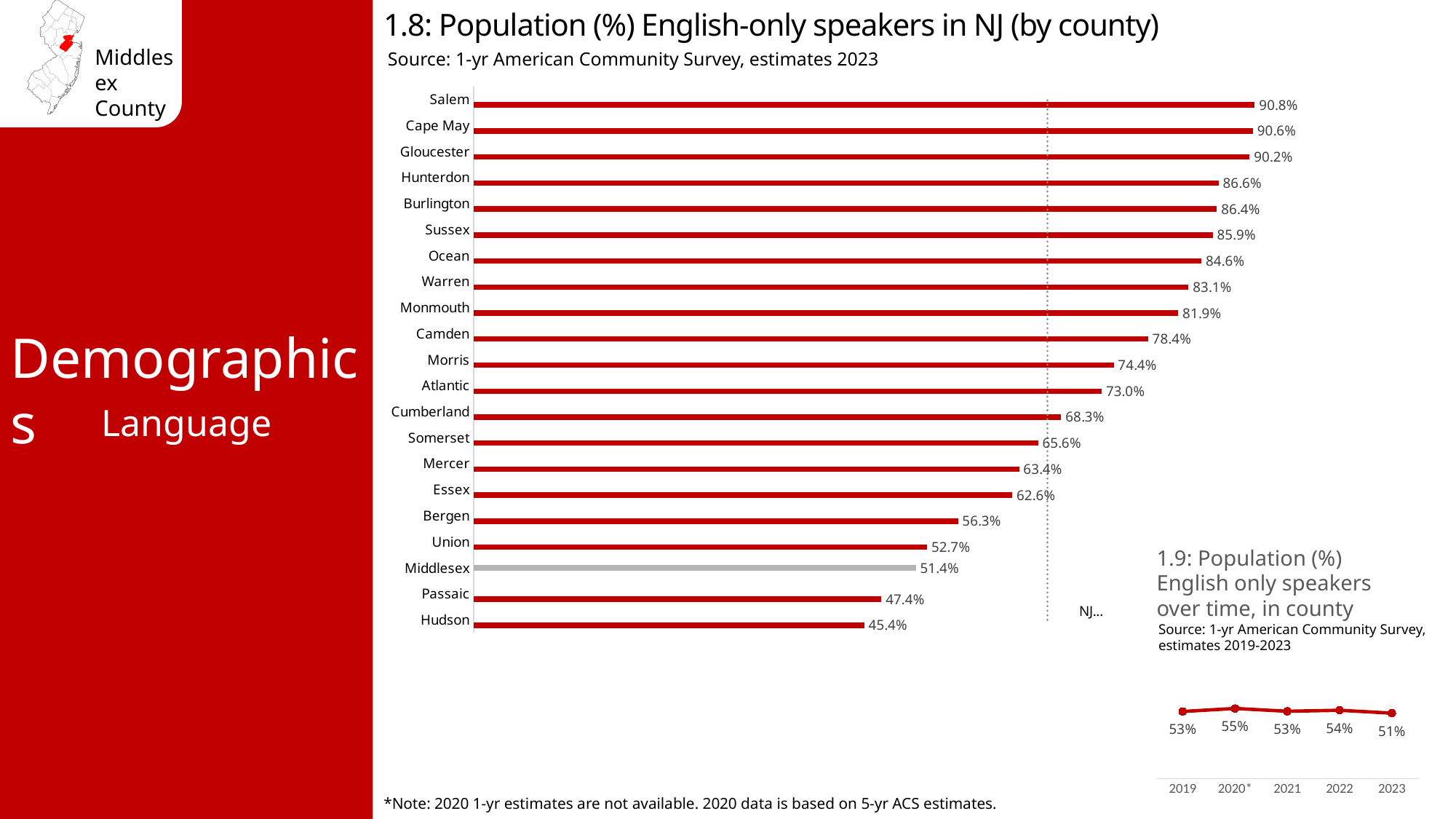
In chart 1.9, what is the value for 2020*? 55% In chart 1.8, which county has a higher value, Camden or Morris? Camden What type of chart is chart 1.8? Bar chart In chart 1.9, which year has the lowest value? 2023 How many counties are shown in chart 1.8? 21 In chart 1.8, which county has the lowest percentage of English-only speakers? Hudson In chart 1.8, what is the value shown for Middlesex? 51.4% In chart 1.8, which county's bar is coloured grey instead of red? Middlesex In chart 1.8, which county has the highest percentage of English-only speakers? Salem In chart 1.8, what percentage of Salem's population are English-only speakers? 90.8% How many data points are plotted in chart 1.9? 5 In chart 1.8, what is the difference between the values for Bergen and Union? 3.6%